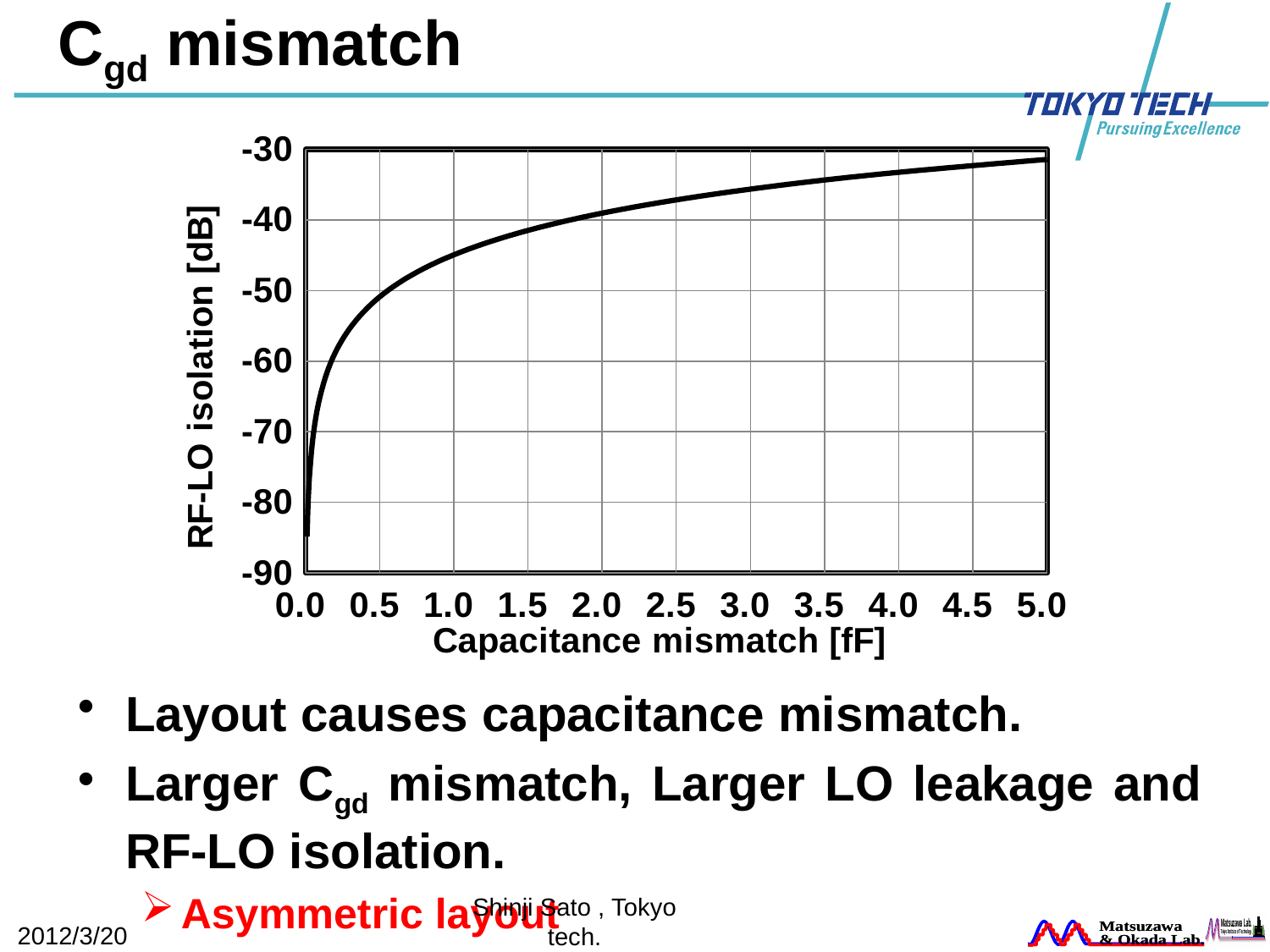
What kind of chart is shown on the slide? line chart Is the RF-LO isolation at a capacitance mismatch of 2.0 fF greater or less than -50 dB? greater Is the RF-LO isolation at a capacitance mismatch of 5.0 fF greater or less than -30 dB? less At which capacitance mismatch on the x axis is the RF-LO isolation highest? 5.0 fF What is the label of the y axis of the chart? RF-LO isolation [dB] Does the RF-LO isolation rise or fall as the capacitance mismatch increases along the x axis? rise Is the RF-LO isolation at a capacitance mismatch of 1.0 fF greater or less than -50 dB? greater Which has the higher RF-LO isolation: a capacitance mismatch of 1.0 fF or 4.0 fF? 4.0 fF At which capacitance mismatch on the x axis is the RF-LO isolation lowest? 0.0 fF What is the label of the x axis of the chart? Capacitance mismatch [fF]